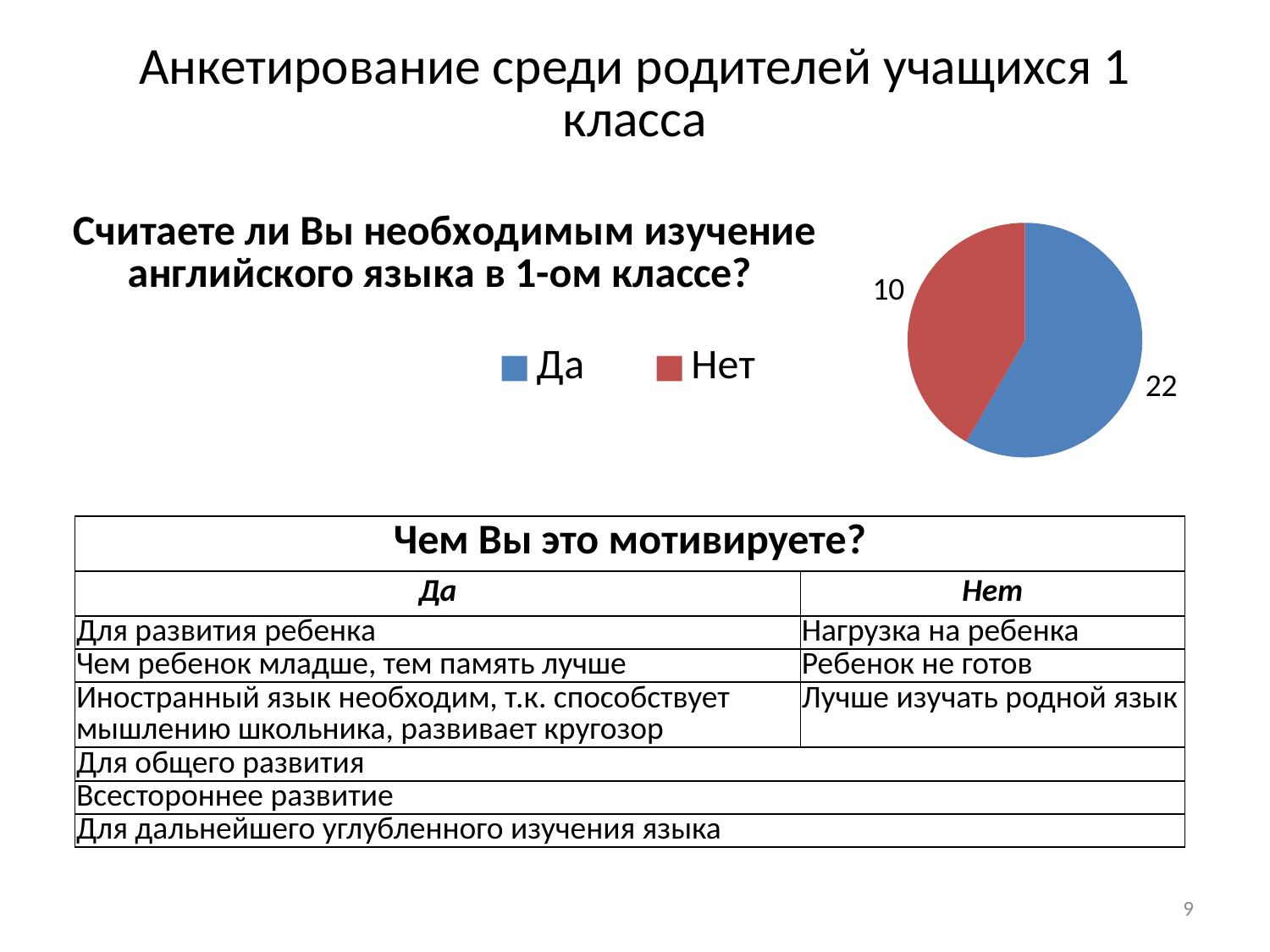
How many parents answered "Да" according to the pie chart? 22 What type of chart is shown on the slide? pie chart What is the difference between the number of "Да" and "Нет" answers in the pie chart? 12 Which answer has the larger slice in the pie chart, "Да" or "Нет"? Да What is the total number of responses shown in the pie chart? 32 How many entries does the pie chart legend list? 2 Which category has the largest slice in the pie chart? Да How many parents answered "Нет" according to the pie chart? 10 Which category has the smallest slice in the pie chart? Нет How many slices does the pie chart have? 2 What colour is the "Нет" slice in the pie chart? red